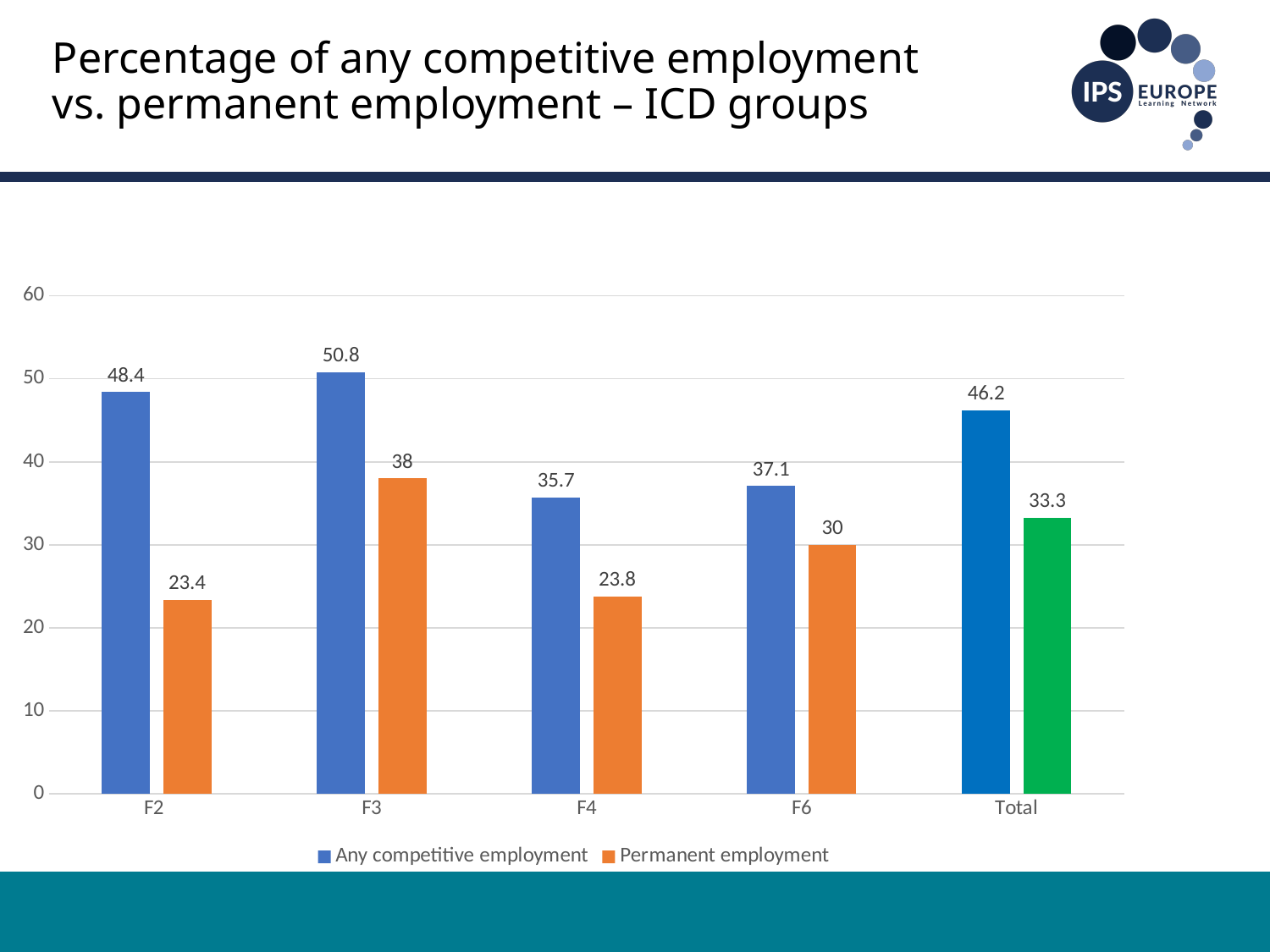
What is the difference between Any competitive employment and Permanent employment in the F2 group? 25 What kind of chart is shown on the slide? Bar chart Which is larger: Permanent employment for F3 or Any competitive employment for F4? Permanent employment for F3 Is the value for Any competitive employment in the Total category greater or less than 40? greater What is the value for Permanent employment in the F6 group? 30 How many series does the legend list? 2 What colour are the Permanent employment bars for the ICD groups F2 to F6? Orange Which ICD group has the lowest value for Permanent employment? F2 How many categories are shown on the x axis? 5 What is the value for Permanent employment in the Total category? 33.3 Which ICD group has the highest value for Any competitive employment? F3 What is the value for Any competitive employment in the F3 group? 50.8